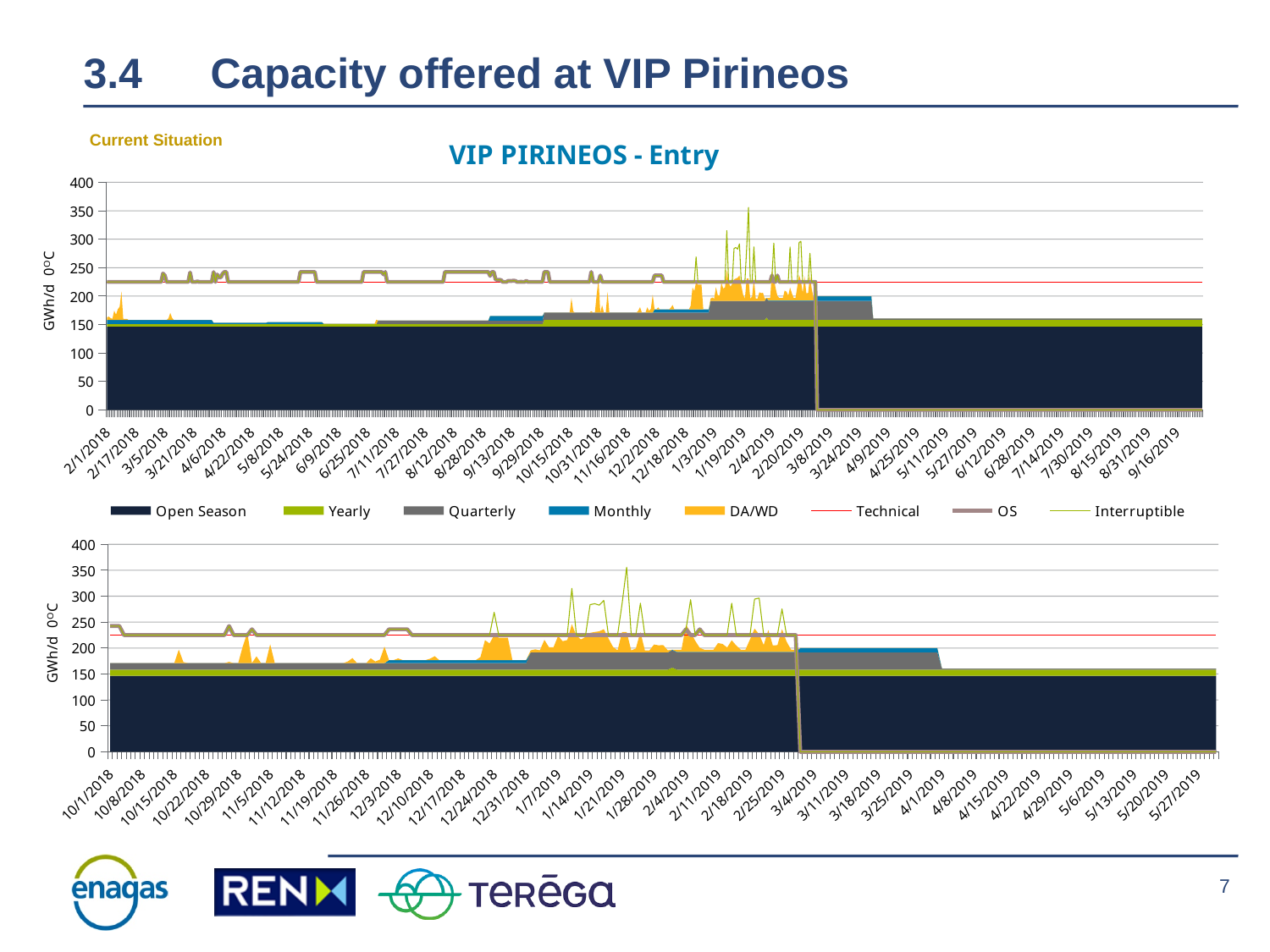
What is the y-axis label of the top chart? GWh/d 0°C In the top chart, is the Open Season value on 9/16/2019 greater or less than 50? greater What is the maximum value shown on the y-axis of the top chart? 400 In the top chart, how many series does the legend list? 8 In the bottom chart, is the Open Season value on 5/27/2019 greater or less than 50? greater What is the title of the top chart? VIP PIRINEOS - Entry What is the first date label on the x-axis of the bottom chart? 10/1/2018 In the top chart, is the Open Season value on 2/1/2018 greater or less than 100? greater What kind of chart is the top chart titled VIP PIRINEOS - Entry? Stacked area chart with line series